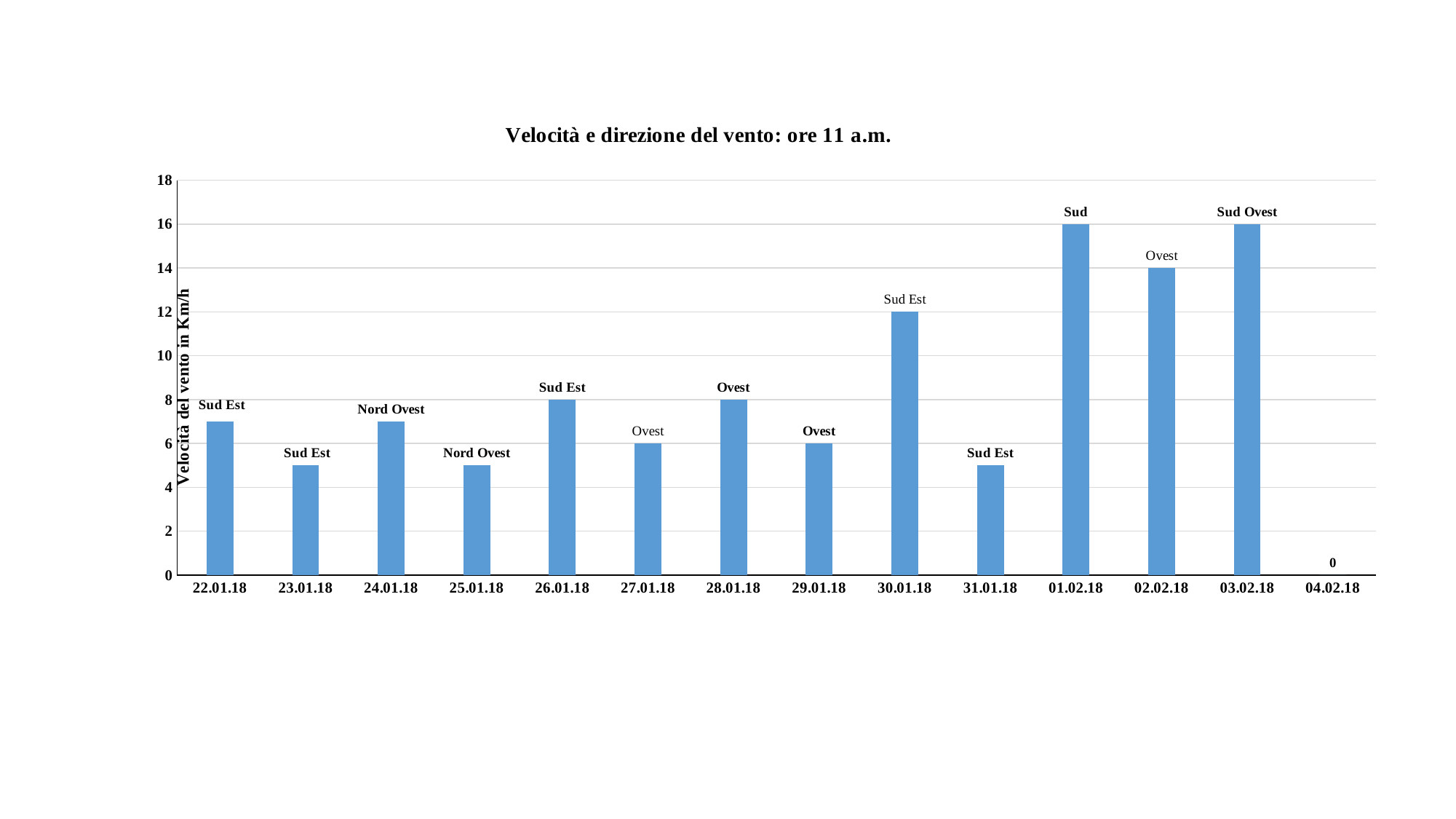
What is the title of the chart? Velocità e direzione del vento: ore 11 a.m. What wind direction label is shown above the bar for 01.02.18? Sud What wind direction label is shown above the bar for 24.01.18? Nord Ovest What is the wind speed in Km/h for 30.01.18? 12 What is the wind speed in Km/h for 26.01.18? 8 What is the wind speed in Km/h for 02.02.18? 14 Which date has the lowest wind speed? 04.02.18 What is the difference in wind speed between 01.02.18 and 02.02.18? 2 Which date has the higher wind speed, 30.01.18 or 28.01.18? 30.01.18 Is the wind speed for 23.01.18 greater or less than 6? less What kind of chart is shown on the slide? bar chart What is the wind speed in Km/h for 04.02.18? 0